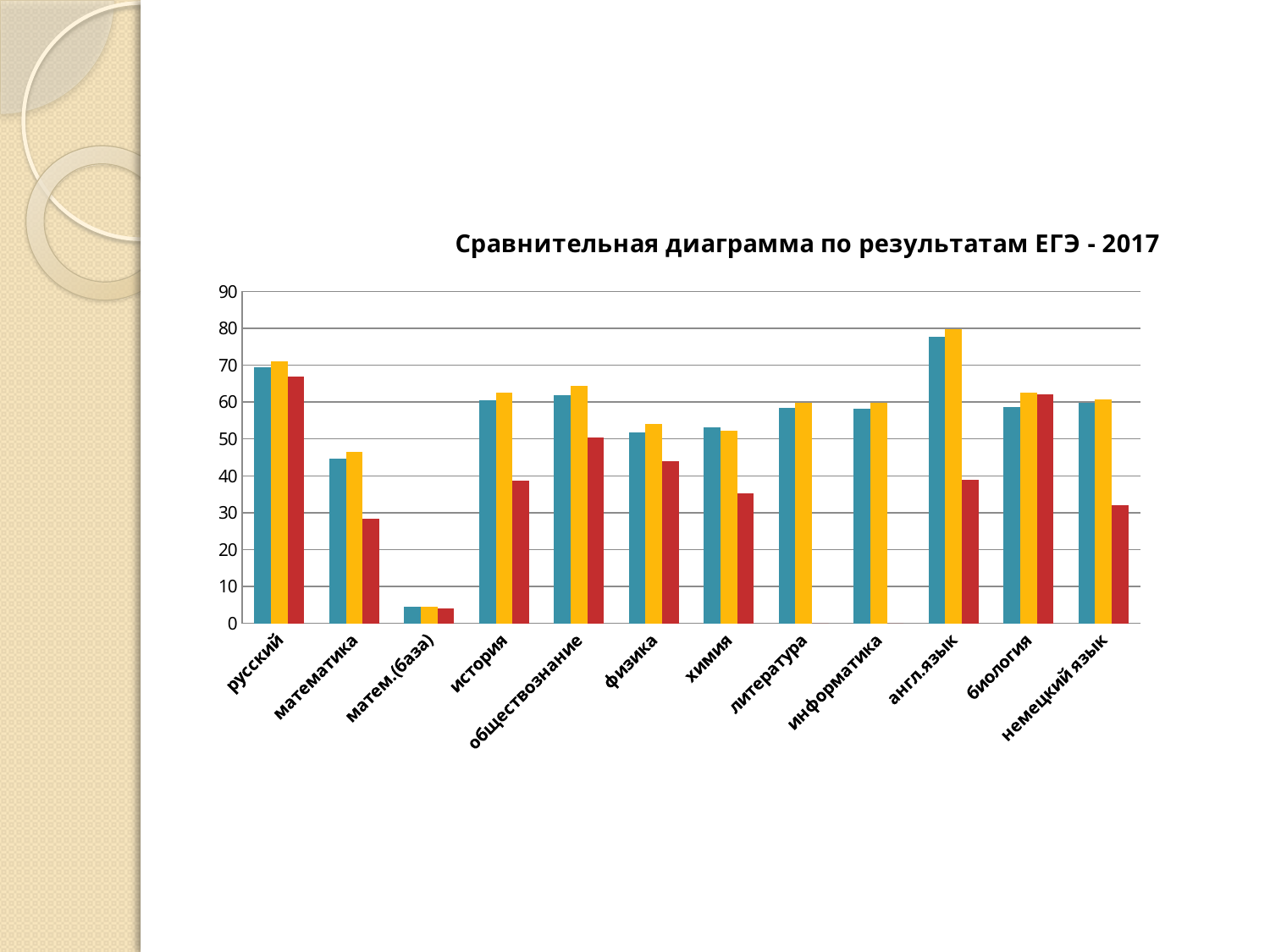
Are the bars for матем.(база) greater or less than 10? less Is the value of the red bar for математика greater or less than 40? less Is the value of the red bar for немецкий язык greater or less than 40? less What is the title of the chart? Сравнительная диаграмма по результатам ЕГЭ - 2017 Which category has the tallest bar in the chart? англ.язык Which is larger: the red bar for русский or the red bar for химия? русский What kind of chart is shown on the slide? bar chart Which categories have only two bars instead of three? литература and информатика How many subject categories are shown on the x axis? 12 Which category has the lowest bars overall? матем.(база)